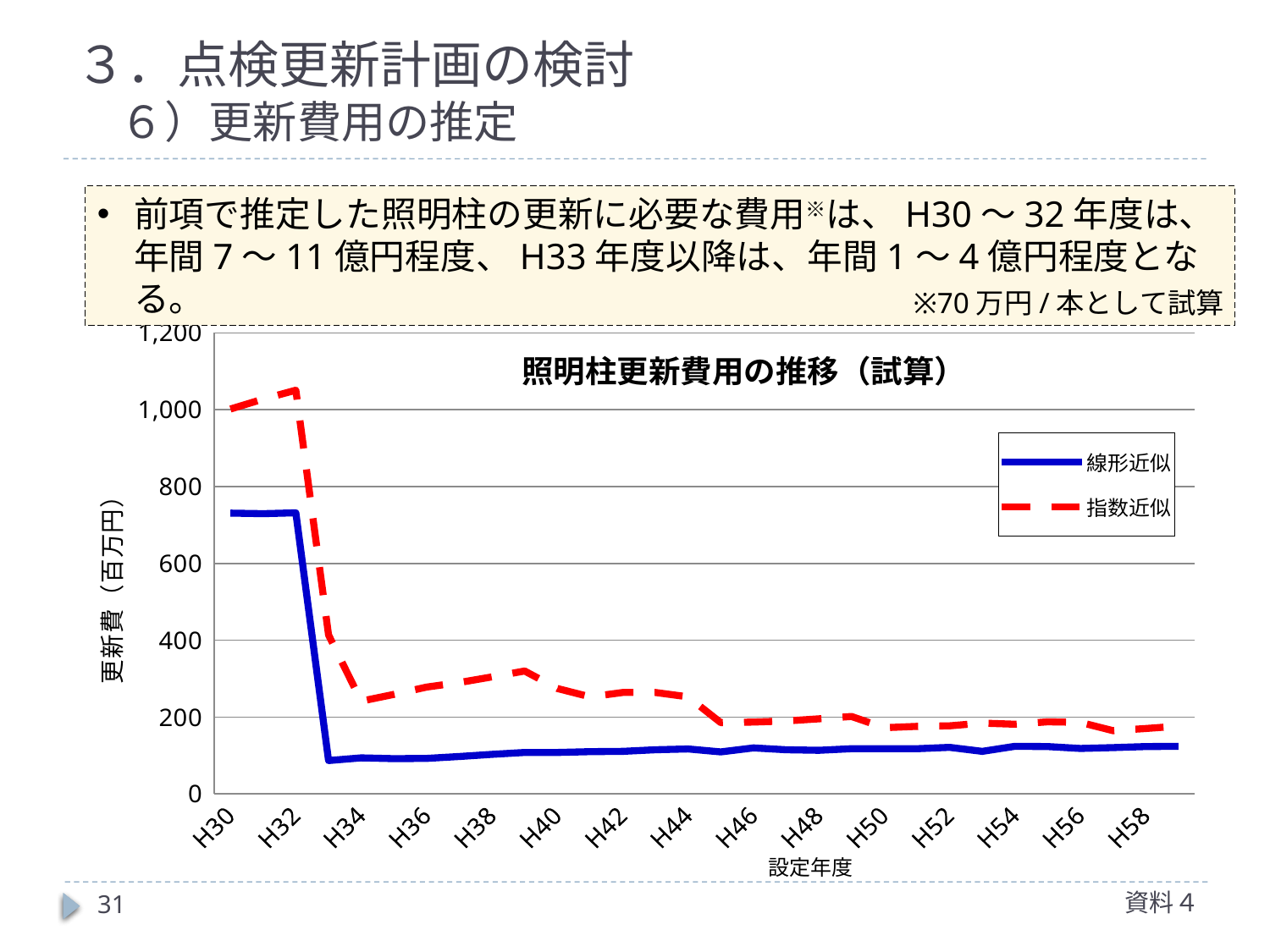
What are the two series named in the chart legend? 線形近似, 指数近似 Is the value of 指数近似 at H34 greater or less than 400? less How many series does the legend of the chart list? 2 At H30, which series has the higher value, 線形近似 or 指数近似? 指数近似 Overall, do the values of 指数近似 rise or fall from H30 to H58? fall Is the value of 指数近似 at H46 greater or less than 400? less Is the value of 線形近似 at H58 greater or less than 200? less What kind of chart is shown on the slide? line chart What is the title of the chart? 照明柱更新費用の推移（試算）